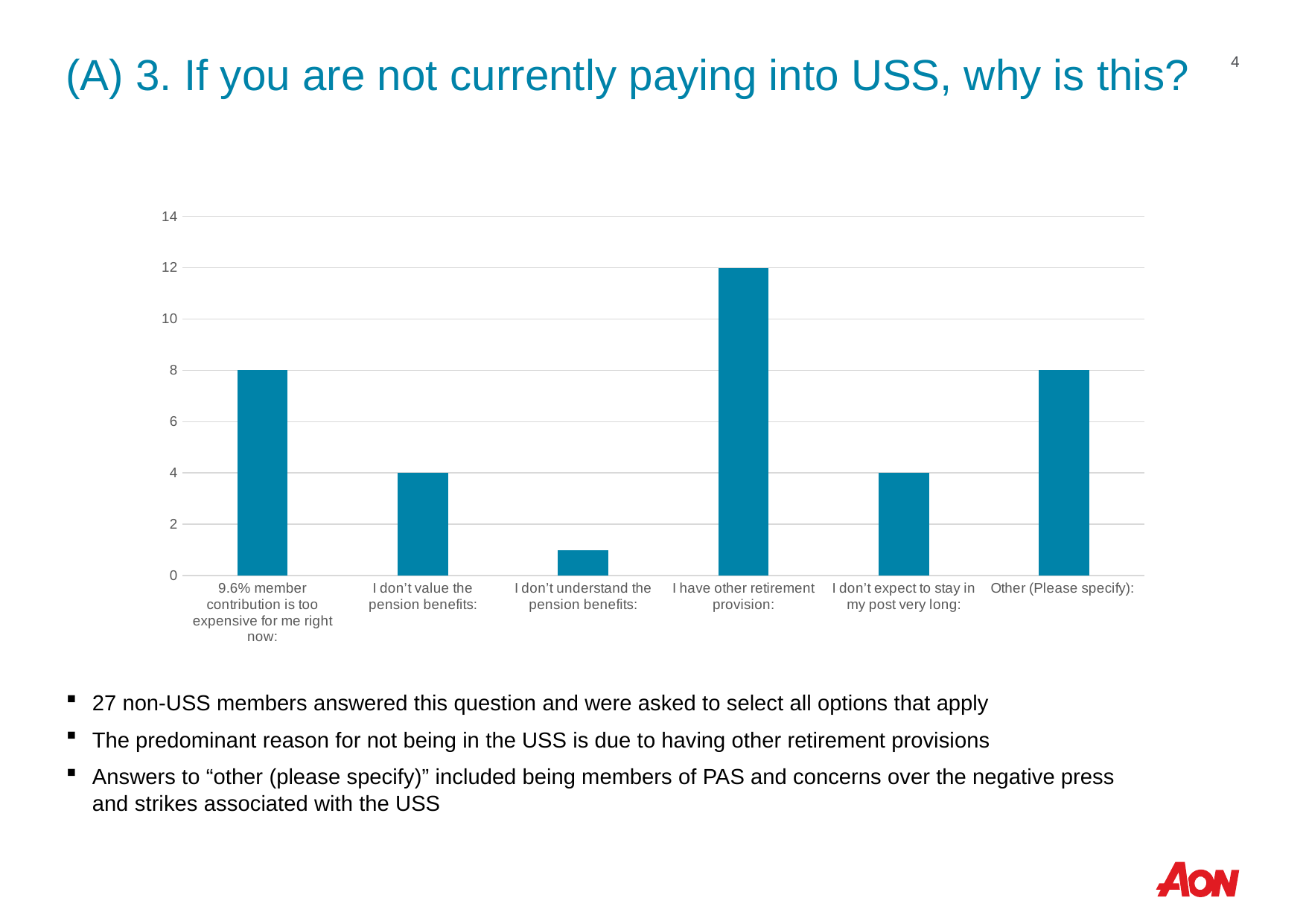
What is the value for "I have other retirement provision:"? 12 Is the value for "I don't understand the pension benefits:" greater or less than 2? less What is the difference between the value for "I have other retirement provision:" and the value for "I don't expect to stay in my post very long:"? 8 What type of chart is shown on the slide? Bar chart What is the value for "Other (Please specify):"? 8 Which reason has the highest bar in the chart? I have other retirement provision: What is the value for "9.6% member contribution is too expensive for me right now:"? 8 What is the value for "I don't value the pension benefits:"? 4 Which is larger: the value for "Other (Please specify):" or the value for "I don't value the pension benefits:"? Other (Please specify): How many categories (reasons) are shown on the x axis of the chart? 6 Which reason has the lowest bar in the chart? I don't understand the pension benefits: What is the highest value shown on the y axis of the chart? 14